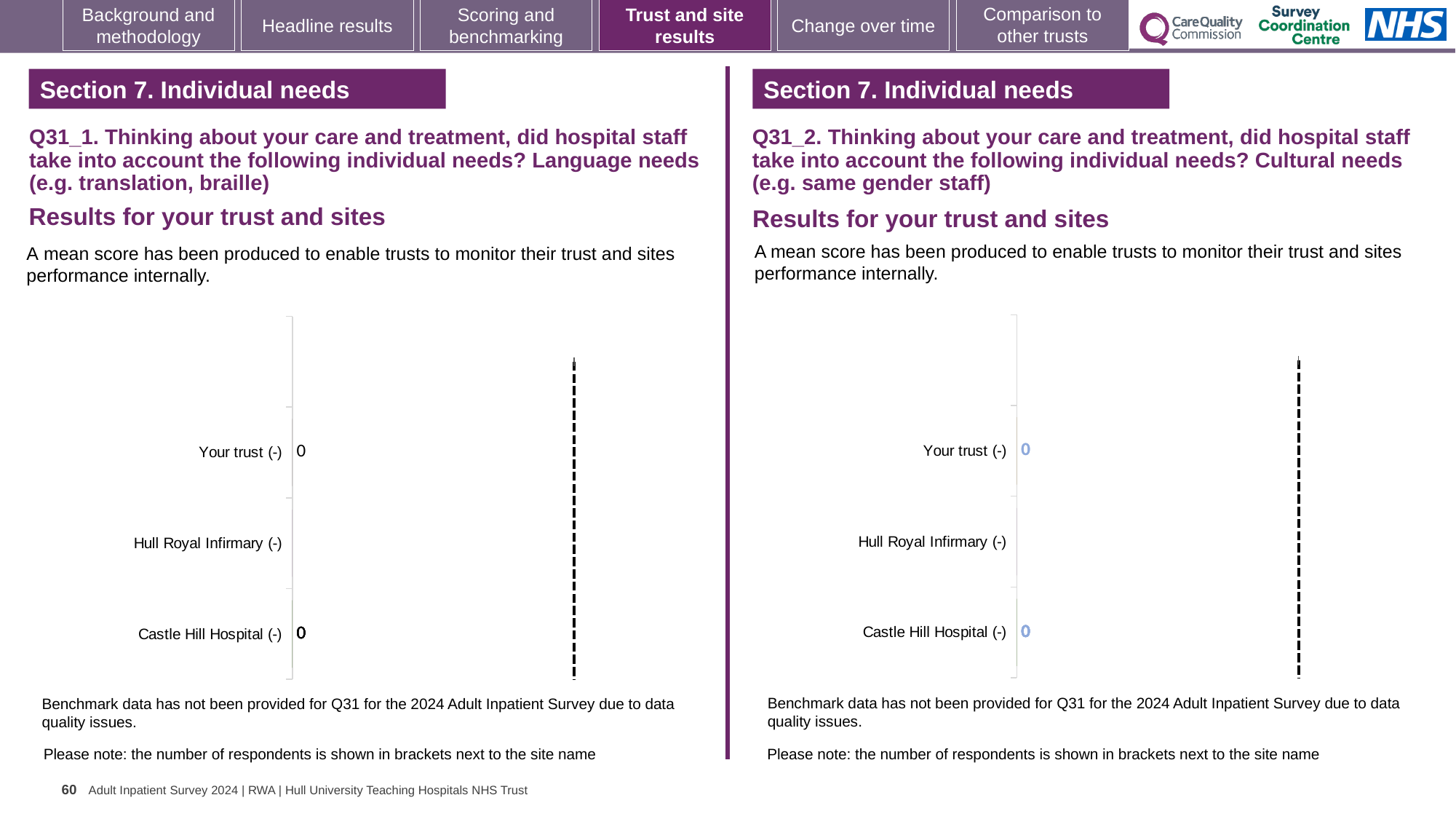
On the right chart (Q31_2, Cultural needs), what is the total of the values shown for Your trust (-) and Castle Hill Hospital (-)? 0 On the right chart (Q31_2, Cultural needs), which category is listed in the middle of the vertical axis? Hull Royal Infirmary (-) On the right chart (Q31_2, Cultural needs), how many categories are listed on the vertical axis? 3 On the right chart (Q31_2, Cultural needs), what value is shown for Your trust (-)? 0 On the right chart (Q31_2, Cultural needs), what value is shown for Castle Hill Hospital (-)? 0 On the left chart (Q31_1, Language needs), what value is shown for Castle Hill Hospital (-)? 0 On the left chart (Q31_1, Language needs), which category is listed at the top of the vertical axis? Your trust (-) On the left chart (Q31_1, Language needs), how many categories are listed on the vertical axis? 3 On the left chart (Q31_1, Language needs), what is the difference between the values for Your trust (-) and Castle Hill Hospital (-)? 0 On the left chart (Q31_1, Language needs), what value is shown for Your trust (-)? 0